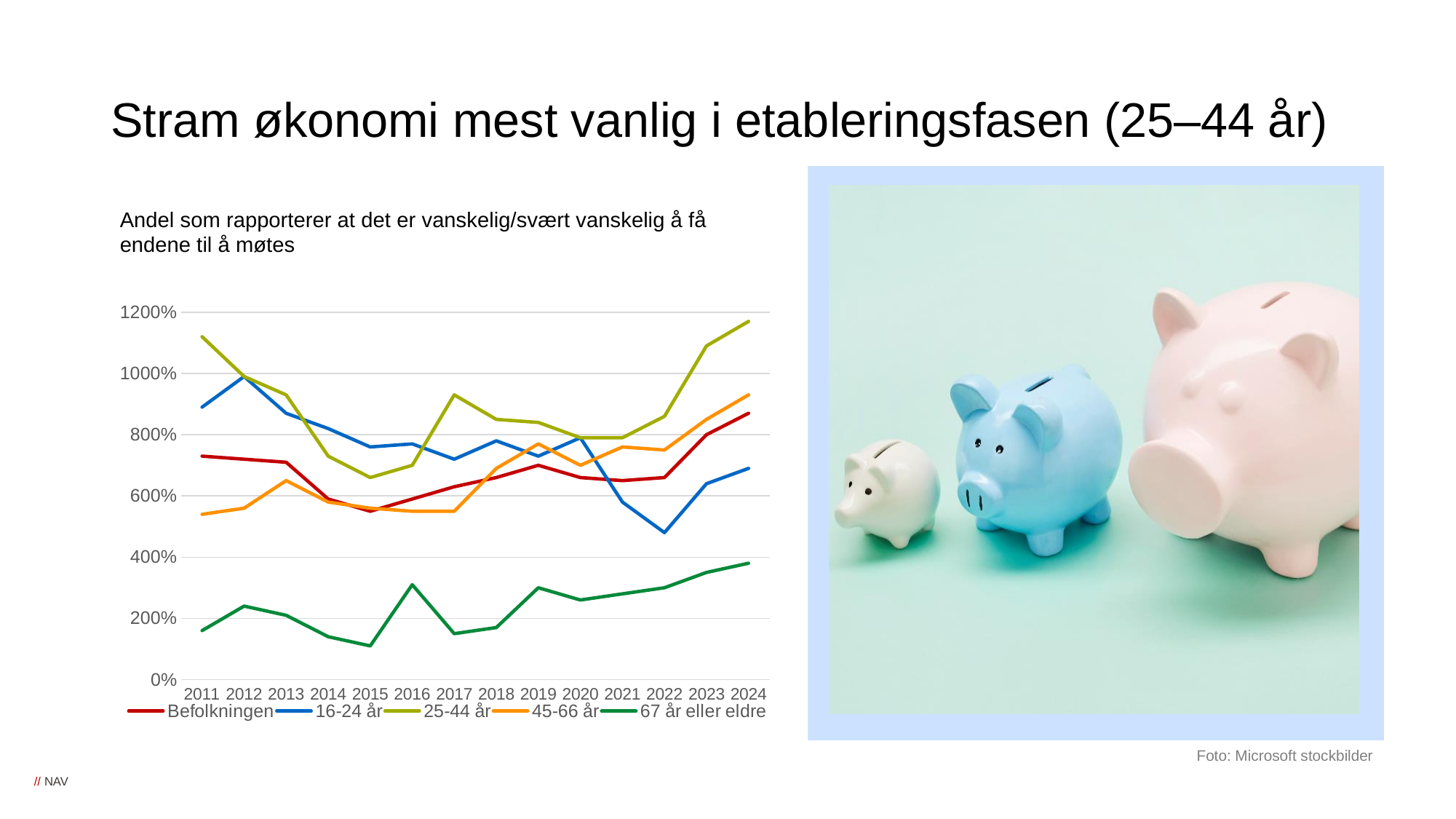
Which series has the highest value in 2024? 25-44 år What kind of chart is shown on the slide? line chart Which series has the lowest value in 2024? 67 år eller eldre Is the value for 67 år eller eldre in 2015 greater or less than 200%? less In 2024, which is larger: the value for 16-24 år or the value for 45-66 år? 45-66 år What is the title of the chart? Andel som rapporterer at det er vanskelig/svært vanskelig å få endene til å møtes How many series does the legend of the chart list? 5 How many years are shown along the x axis of the chart? 14 In which year does the 16-24 år series reach its lowest value? 2022 Is the value for 25-44 år in 2024 greater or less than 1000%? greater Does the value for 16-24 år rise or fall from 2012 to 2015? fall Is the value for 16-24 år in 2022 greater or less than 600%? less